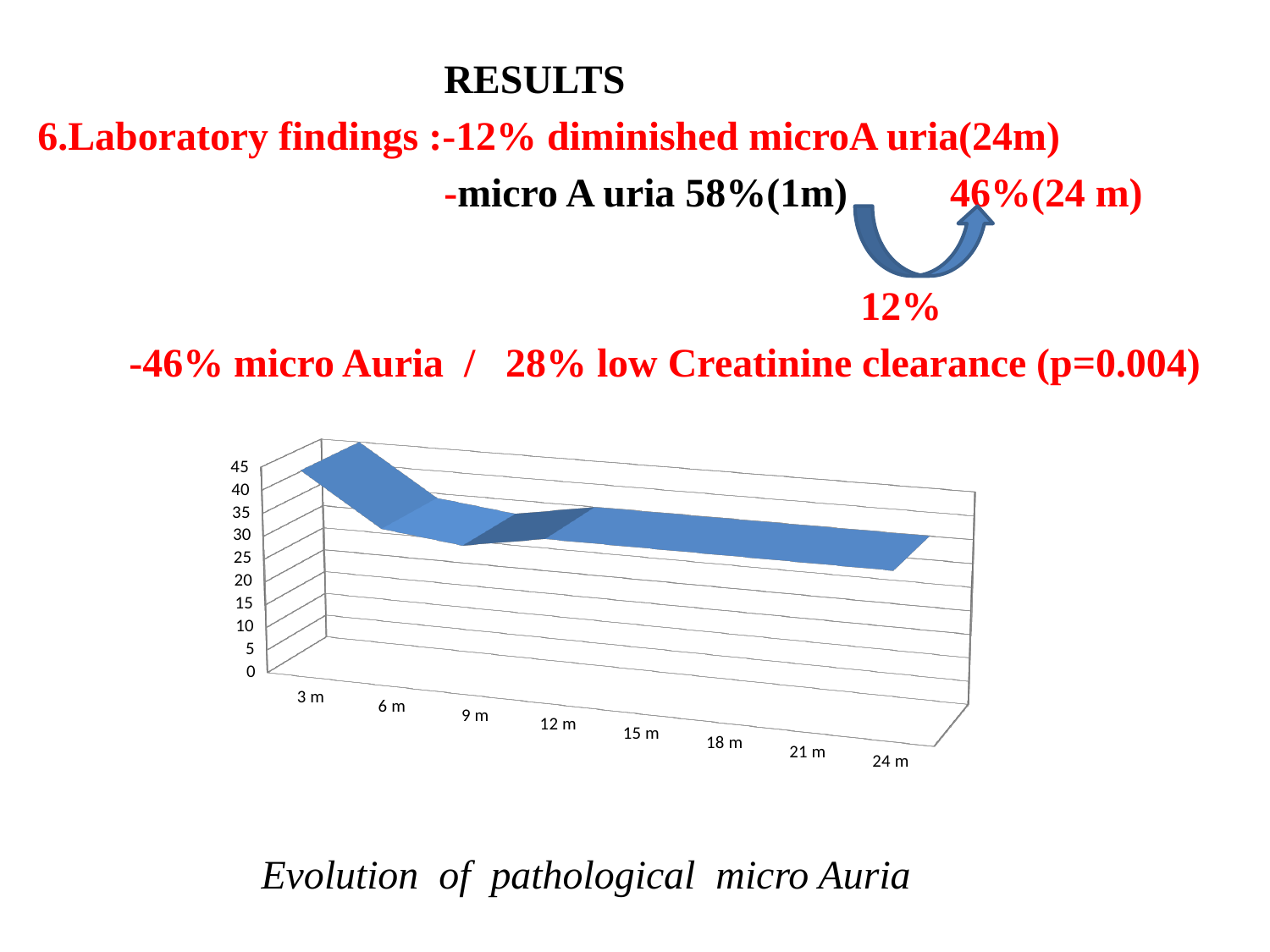
Is the value at 24 m greater or less than 40? less What is the last time point on the x axis of the chart? 24 m How many time points are shown on the x axis of the chart? 8 What is the highest tick value shown on the vertical axis of the chart? 45 Which time point has the highest value in the chart? 3 m What kind of chart is shown on the slide? 3D line chart Is the value at 9 m greater or less than 40? less Is the value at 3 m greater or less than 35? greater What is the caption written below the chart? Evolution of pathological micro Auria Do the values in the chart generally rise or fall from 3 m to 24 m? fall What is the first time point on the x axis of the chart? 3 m Which is larger in the chart, the value at 3 m or the value at 24 m? 3 m